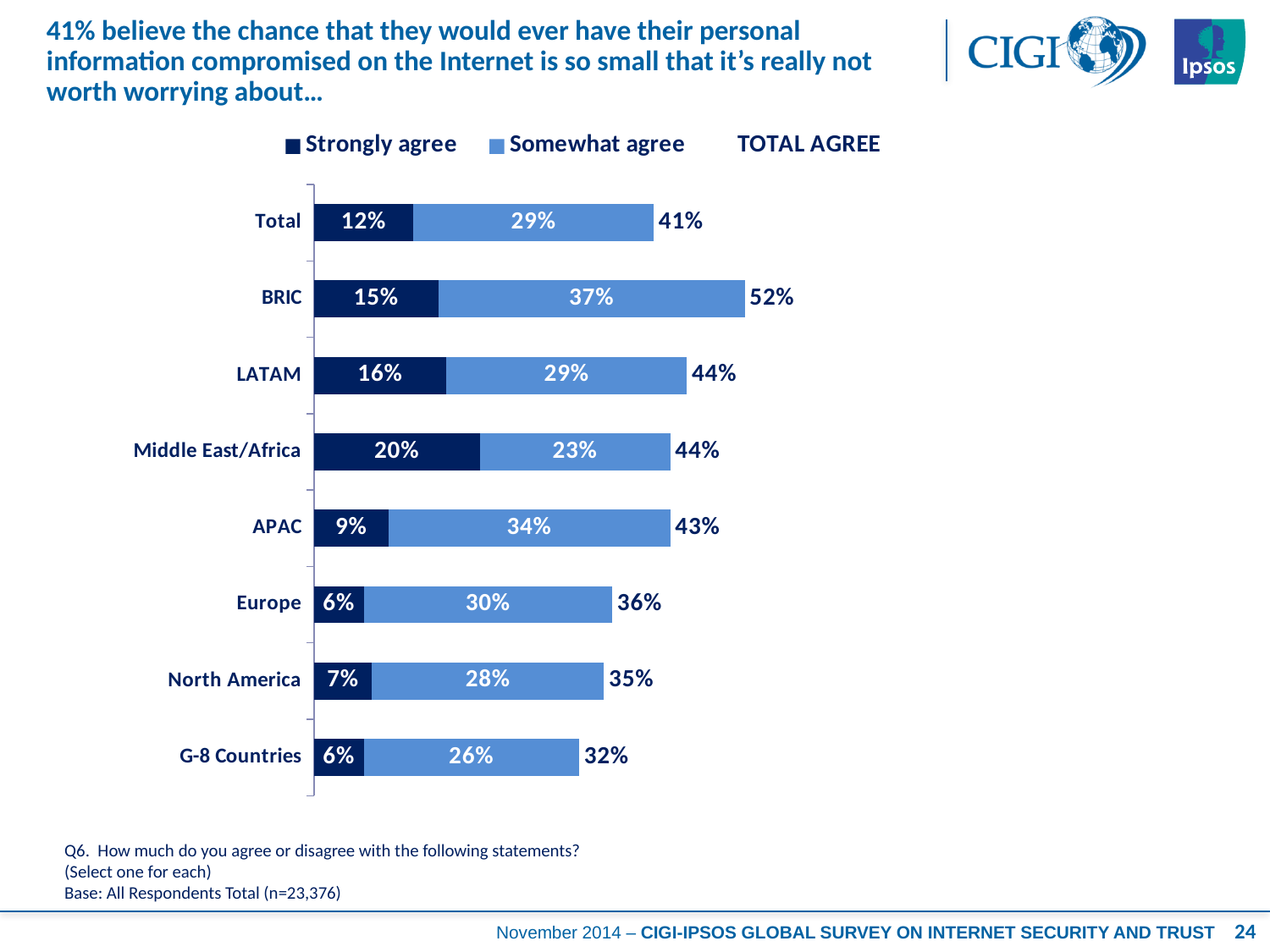
What kind of chart is shown on the slide? Stacked bar chart How many categories are shown on the chart? 8 Which is larger, the Strongly agree value for LATAM or for APAC? LATAM What is the Strongly agree value for BRIC? 15% What is the difference between the Somewhat agree values for BRIC and G-8 Countries? 11% What is the total of the stacked bar for North America? 35% How many series does the legend list? 3 Which region has the highest Strongly agree value? Middle East/Africa Which category has the lowest TOTAL AGREE value? G-8 Countries Which series is shown in dark navy blue? Strongly agree What is the TOTAL AGREE value for Europe? 36% What is the Somewhat agree value for APAC? 34%